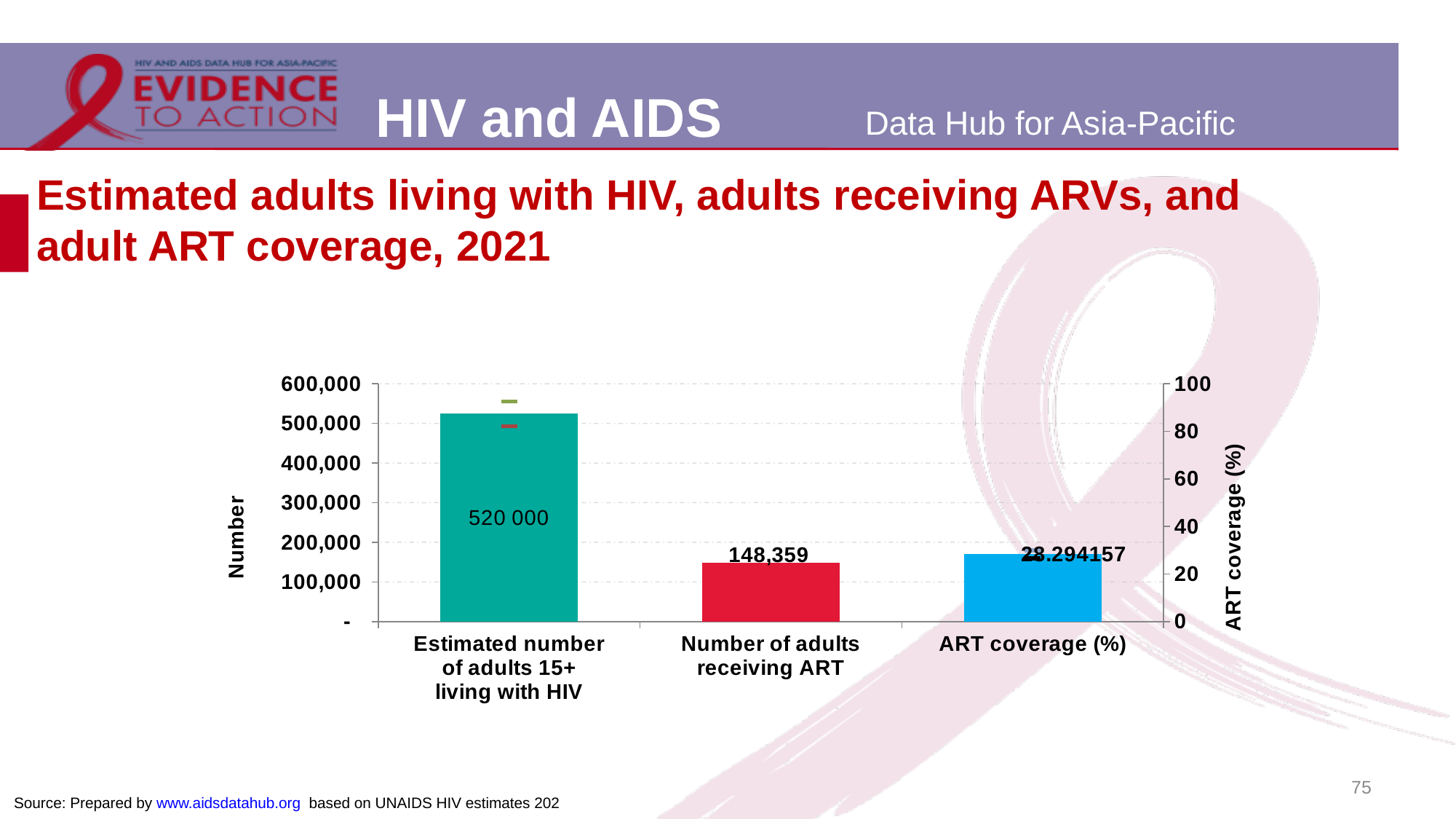
What is the label of the left-hand vertical axis? Number How many categories are shown on the x axis? 3 Which is larger: the estimated number of adults 15+ living with HIV or the number of adults receiving ART? Estimated number of adults 15+ living with HIV What is the label of the right-hand vertical axis? ART coverage (%) Is the ART coverage (%) value, read on the right axis, greater or less than 40? less Which category has the tallest bar? Estimated number of adults 15+ living with HIV What is the value for the estimated number of adults 15+ living with HIV? 520 000 What kind of chart is shown on the slide? Bar chart Is the number of adults receiving ART greater or less than 200,000? less What is the difference between the estimated number of adults 15+ living with HIV and the number of adults receiving ART? 371,641 Is the ART coverage (%) value, read on the right axis, greater or less than 20? greater What is the value for the number of adults receiving ART? 148,359